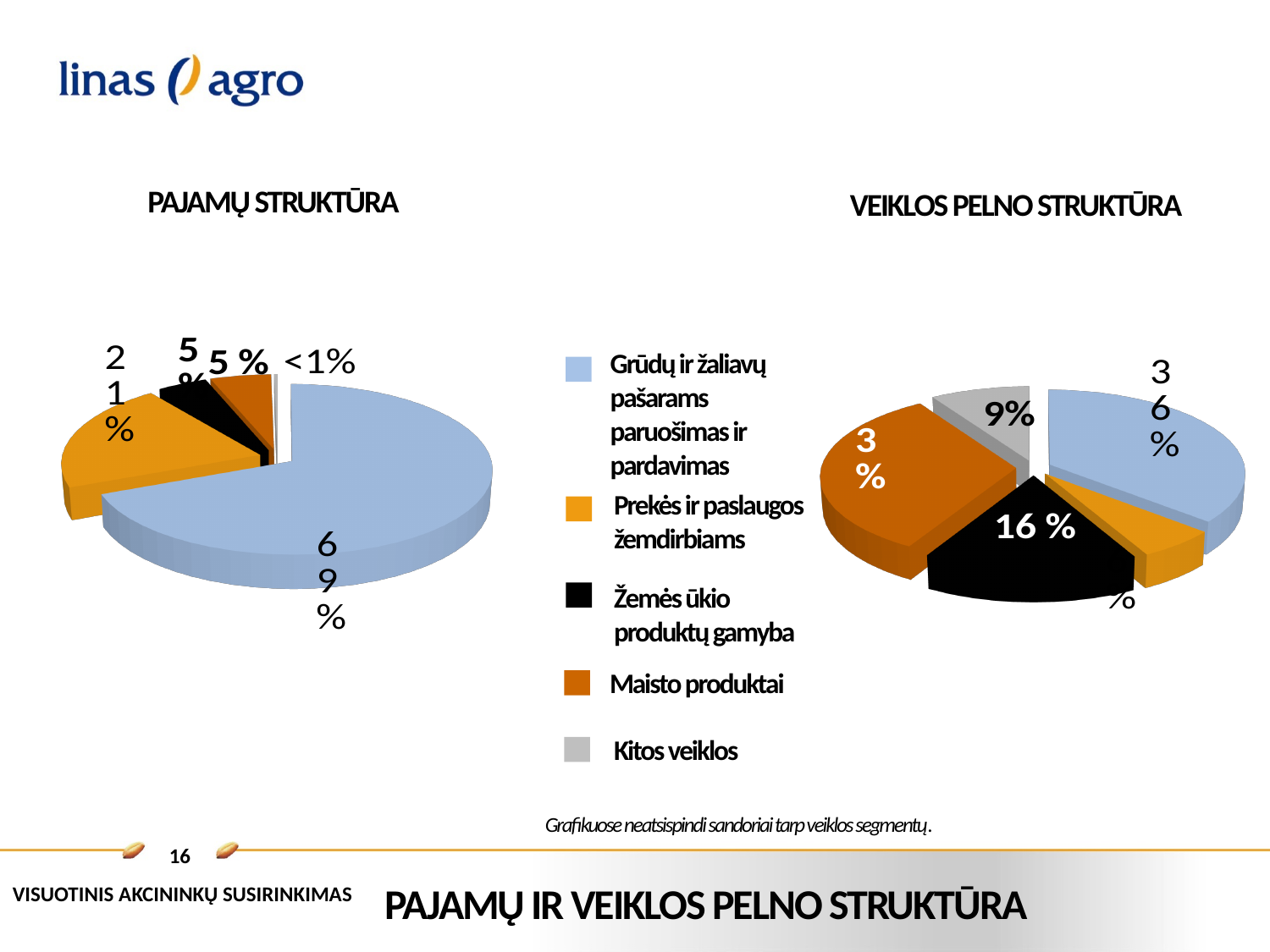
On the PAJAMŲ STRUKTŪRA chart, which segment has the smallest share? Kitos veiklos On the PAJAMŲ STRUKTŪRA chart, by how many percentage points does Grūdų ir žaliavų pašarams paruošimas ir pardavimas exceed Prekės ir paslaugos žemdirbiams? 48 percentage points On the VEIKLOS PELNO STRUKTŪRA chart, what share is shown for Grūdų ir žaliavų pašarams paruošimas ir pardavimas? 36% On the VEIKLOS PELNO STRUKTŪRA chart, what share is shown for Kitos veiklos? 9% What type of chart is the PAJAMŲ STRUKTŪRA chart? Pie chart On the VEIKLOS PELNO STRUKTŪRA chart, which is larger: Grūdų ir žaliavų pašarams paruošimas ir pardavimas or Žemės ūkio produktų gamyba? Grūdų ir žaliavų pašarams paruošimas ir pardavimas On the PAJAMŲ STRUKTŪRA chart, what share is shown for Prekės ir paslaugos žemdirbiams? 21% On the PAJAMŲ STRUKTŪRA chart, what share is shown for Kitos veiklos? <1% On the PAJAMŲ STRUKTŪRA chart, what share is shown for Grūdų ir žaliavų pašarams paruošimas ir pardavimas? 69% How many segments does the legend list for the two charts? 5 On the VEIKLOS PELNO STRUKTŪRA chart, what share is shown for Žemės ūkio produktų gamyba? 16 % On the PAJAMŲ STRUKTŪRA chart, which segment has the largest share? Grūdų ir žaliavų pašarams paruošimas ir pardavimas